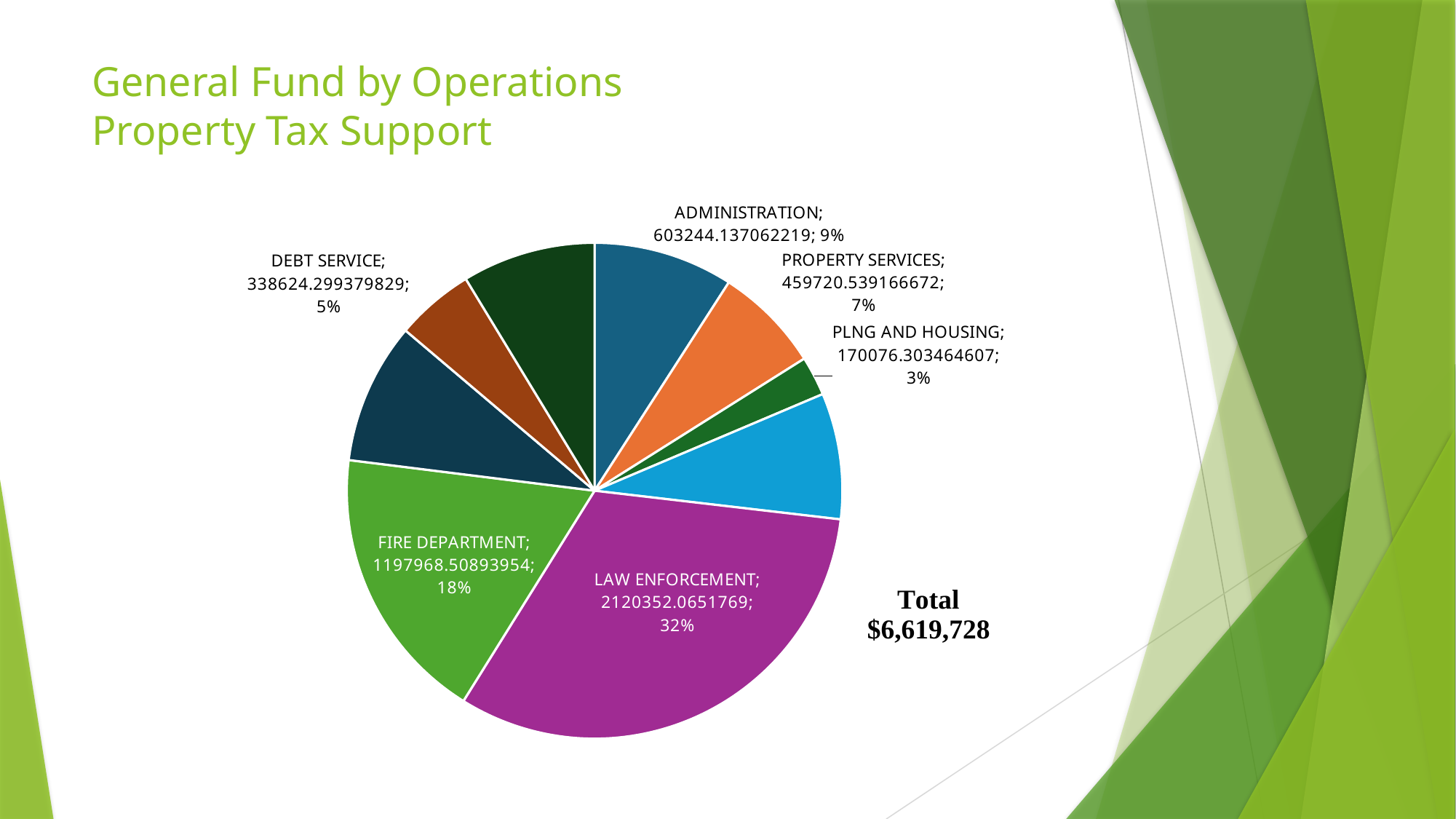
What is the title of the chart on the slide? General Fund by Operations Property Tax Support What kind of chart is shown on the slide? Pie chart What total amount is printed next to the pie chart? $6,619,728 Which has a larger share, Administration or Property Services? Administration What value is shown for Administration? 603244.137062219 What percentage share of the pie does Law Enforcement have? 32% Which category has the largest slice of the pie? Law Enforcement Which category has the smallest slice of the pie? Plng and Housing What value is shown for Plng and Housing? 170076.303464607 What percentage share of the pie does Fire Department have? 18% What value is shown for Debt Service? 338624.299379829 What is the difference in percentage points between the Law Enforcement share and the Fire Department share? 14 percentage points